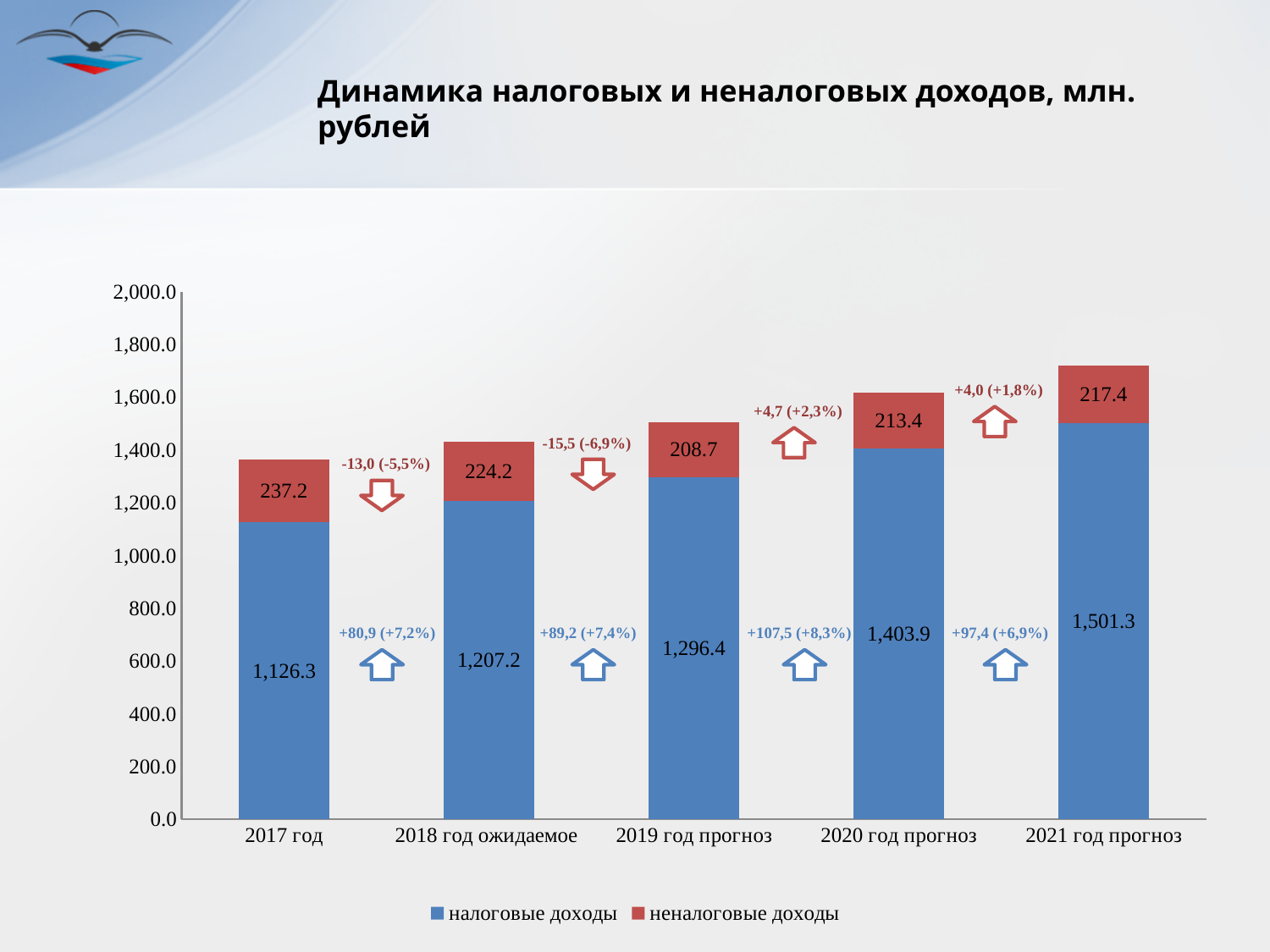
What type of chart is shown on the slide? stacked bar chart How many series does the legend list? 2 What is the value of неналоговые доходы for 2019 год прогноз? 208.7 Do the values of налоговые доходы rise or fall from 2017 год to 2021 год прогноз? rise Which year has the highest value of неналоговые доходы? 2017 год What is the difference between налоговые доходы in 2020 год прогноз and 2019 год прогноз? 107.5 Which is larger: неналоговые доходы in 2018 год ожидаемое or in 2021 год прогноз? 2018 год ожидаемое What is the value of налоговые доходы for 2017 год? 1,126.3 How many years (categories) are shown on the x axis? 5 What is the total of the stacked bar for 2017 год? 1,363.5 What is the value of налоговые доходы for 2021 год прогноз? 1,501.3 Which year has the lowest value of налоговые доходы? 2017 год